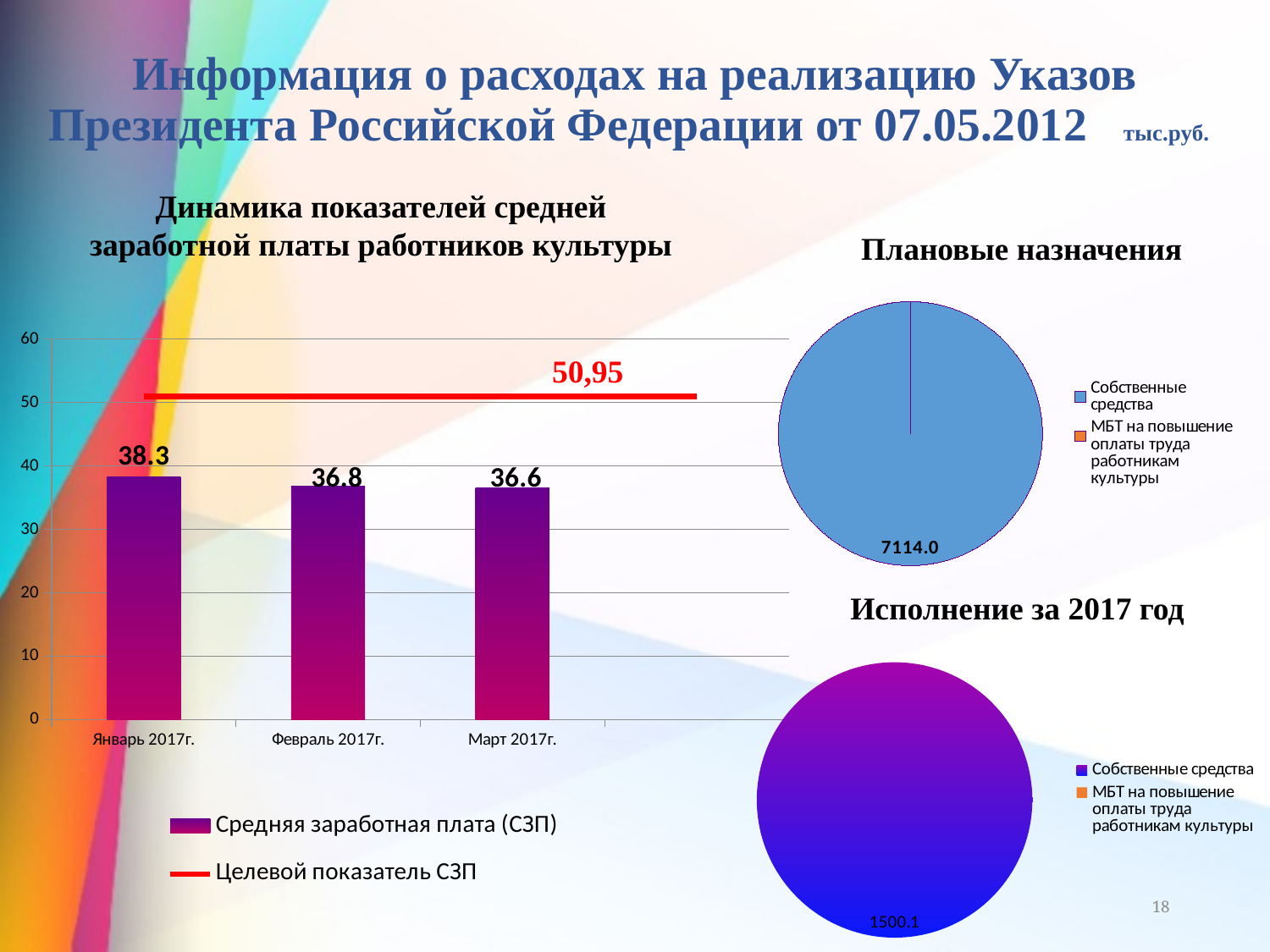
On the chart 'Динамика показателей средней заработной платы работников культуры', what is the value for Январь 2017г.? 38.3 On the chart 'Динамика показателей средней заработной платы работников культуры', what is the difference between the values for Январь 2017г. and Февраль 2017г.? 1.5 On the chart 'Динамика показателей средней заработной платы работников культуры', which month has the lowest average salary? Март 2017г. On the pie chart 'Исполнение за 2017 год', what value is printed as the data label? 1500.1 On the chart 'Динамика показателей средней заработной платы работников культуры', is the value for Февраль 2017г. greater or less than 40? less On the chart 'Динамика показателей средней заработной платы работников культуры', what is the value of the target line 'Целевой показатель СЗП'? 50,95 On the chart 'Динамика показателей средней заработной платы работников культуры', how many months are shown on the x axis? 3 On the chart 'Динамика показателей средней заработной платы работников культуры', do the bar values rise or fall from Январь to Март 2017г.? fall On the chart 'Динамика показателей средней заработной платы работников культуры', what is the value for Март 2017г.? 36.6 On the chart 'Динамика показателей средней заработной платы работников культуры', which month has the highest average salary? Январь 2017г. On the pie chart 'Плановые назначения', what value is printed on the 'Собственные средства' slice? 7114.0 What kind of chart is 'Плановые назначения'? pie chart